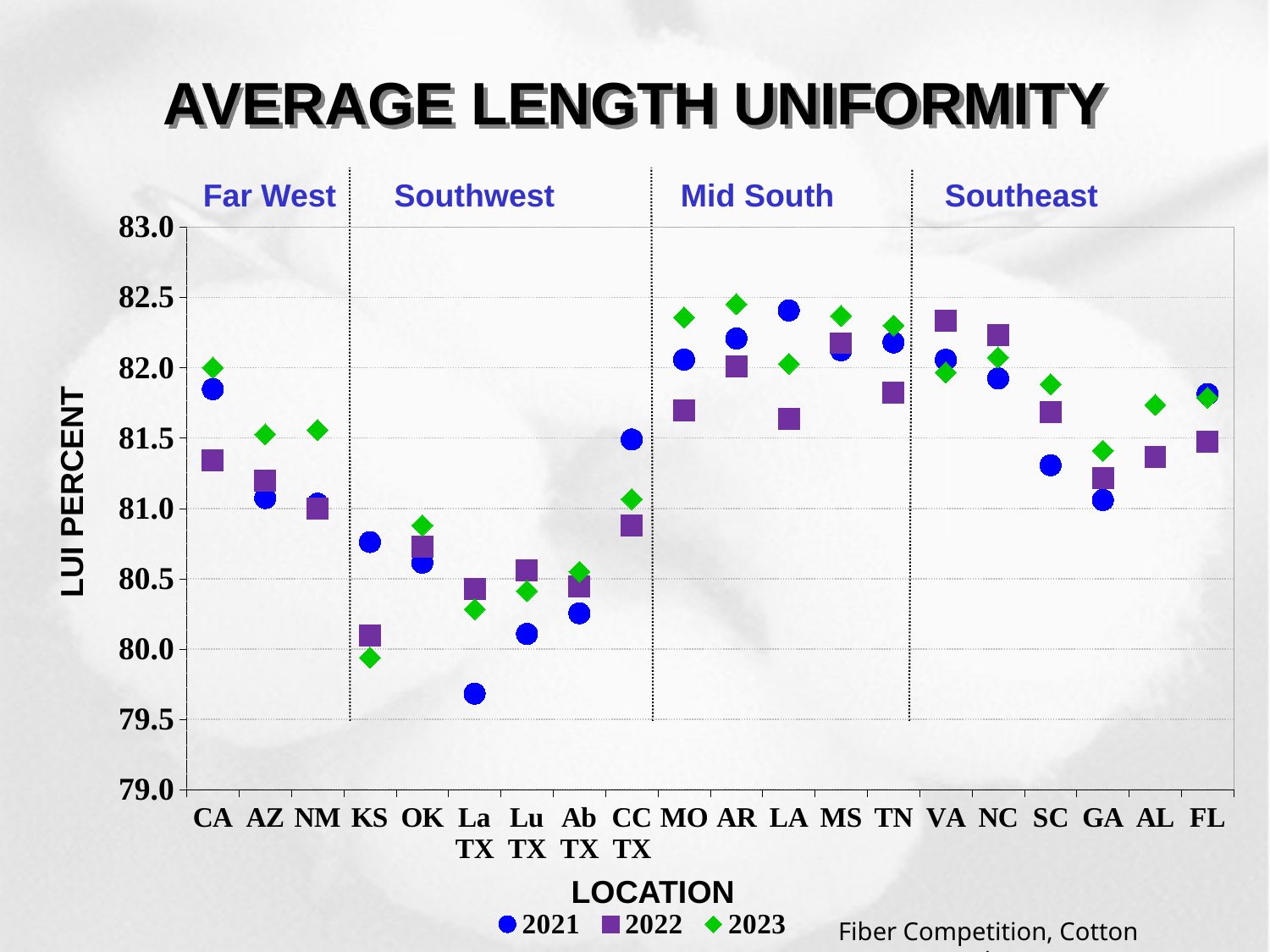
What is the title of the chart? AVERAGE LENGTH UNIFORMITY Which location has the lowest 2021 value? La TX Which location has the lowest 2023 value? KS Which location has the lowest 2022 value? KS Is the 2021 value for GA greater or less than 81.5? less How many series does the legend list? 3 Is the 2021 value for La TX greater or less than 80.0? less Which location has the highest 2021 value? LA Which is larger, the 2021 value for CA or the 2021 value for AZ? CA What kind of chart is shown on the slide? Scatter chart Is the 2021 value for LA greater or less than 82.0? greater How many locations are plotted along the x axis? 20